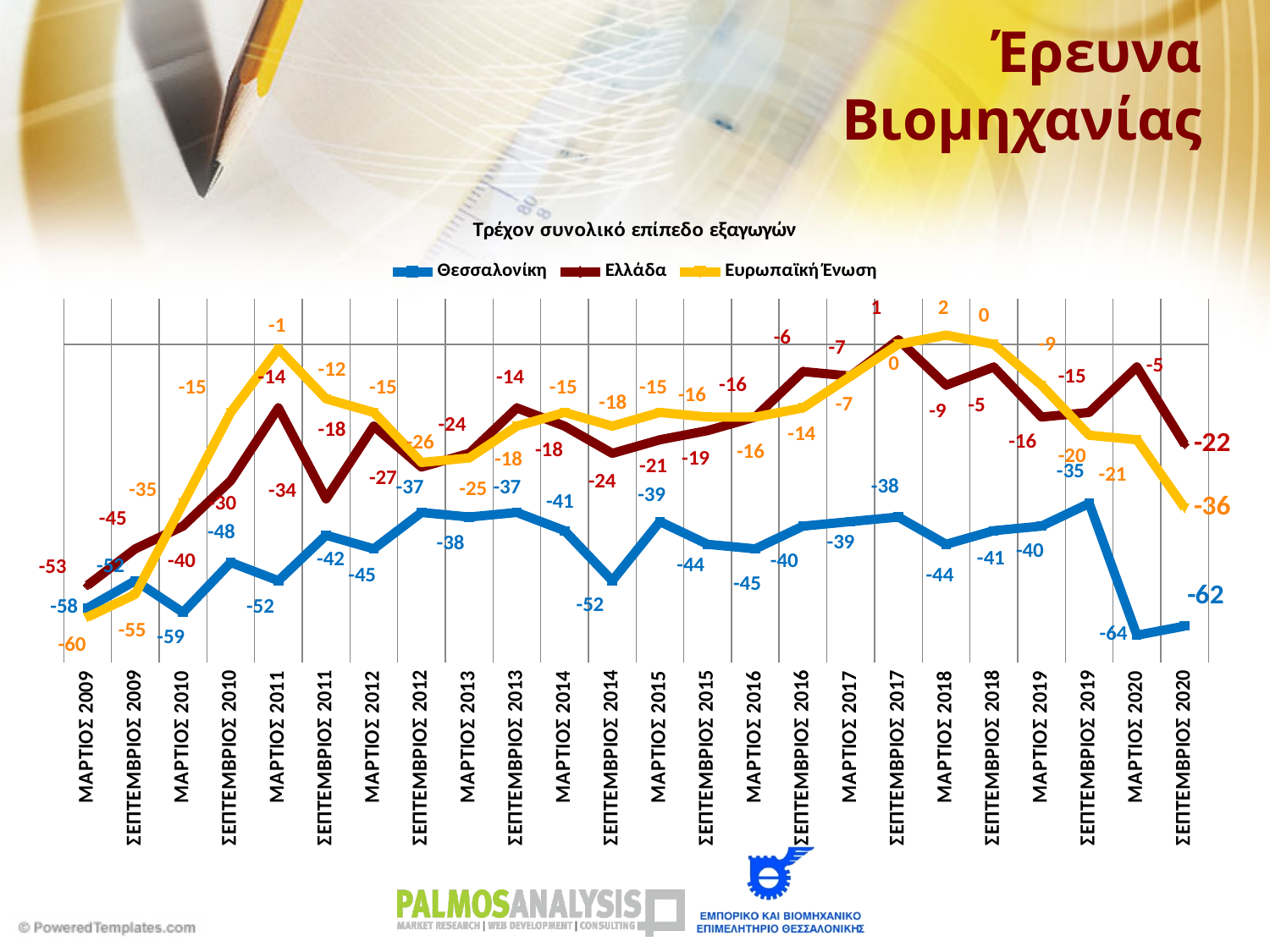
What is the value for Θεσσαλονίκη in ΣΕΠΤΕΜΒΡΙΟΣ 2020? -62 What is the value for Ελλάδα in ΣΕΠΤΕΜΒΡΙΟΣ 2020? -22 What is the value for Ευρωπαϊκή Ένωση in ΜΑΡΤΙΟΣ 2011? -1 At which time point does Θεσσαλονίκη reach its lowest value? ΜΑΡΤΙΟΣ 2020 What is the title of the chart? Τρέχον συνολικό επίπεδο εξαγωγών At which time point does Ευρωπαϊκή Ένωση reach its highest value? ΜΑΡΤΙΟΣ 2018 Does the Θεσσαλονίκη line rise or fall from ΣΕΠΤΕΜΒΡΙΟΣ 2019 to ΜΑΡΤΙΟΣ 2020? fall What is the difference between the Ελλάδα and Θεσσαλονίκη values in ΣΕΠΤΕΜΒΡΙΟΣ 2020? 40 What kind of chart is shown on the slide? line chart How many series does the legend list? 3 In ΜΑΡΤΙΟΣ 2020, which is higher: Ελλάδα or Θεσσαλονίκη? Ελλάδα How many time points are plotted along the x axis? 24